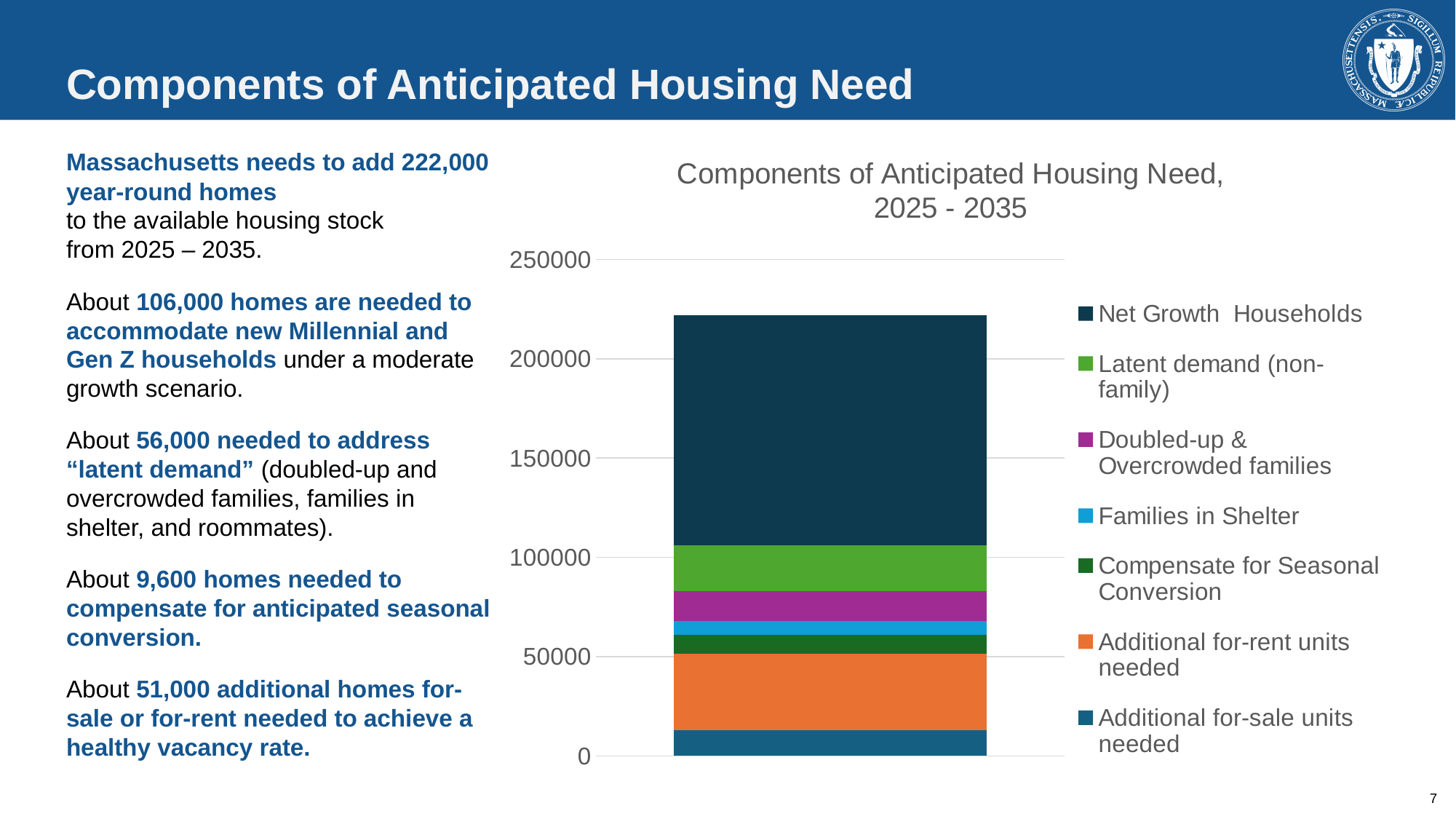
How many stacked bars are plotted in the chart? 1 Which series is plotted at the bottom of the stacked bar? Additional for-sale units needed What is the highest value shown on the vertical axis? 250000 What is the title of the chart? Components of Anticipated Housing Need, 2025 - 2035 Which series makes up the largest segment of the stacked bar? Net Growth Households Is the value for the Additional for-rent units needed segment greater or less than 50000? less Is the total height of the stacked bar greater or less than 200000? greater Which segment is larger: Additional for-rent units needed or Additional for-sale units needed? Additional for-rent units needed How many series does the chart legend list? 7 What kind of chart is shown on the slide? Stacked bar chart Which segment is larger: Net Growth Households or Additional for-rent units needed? Net Growth Households Is the value for the Net Growth Households segment greater or less than 100000? greater